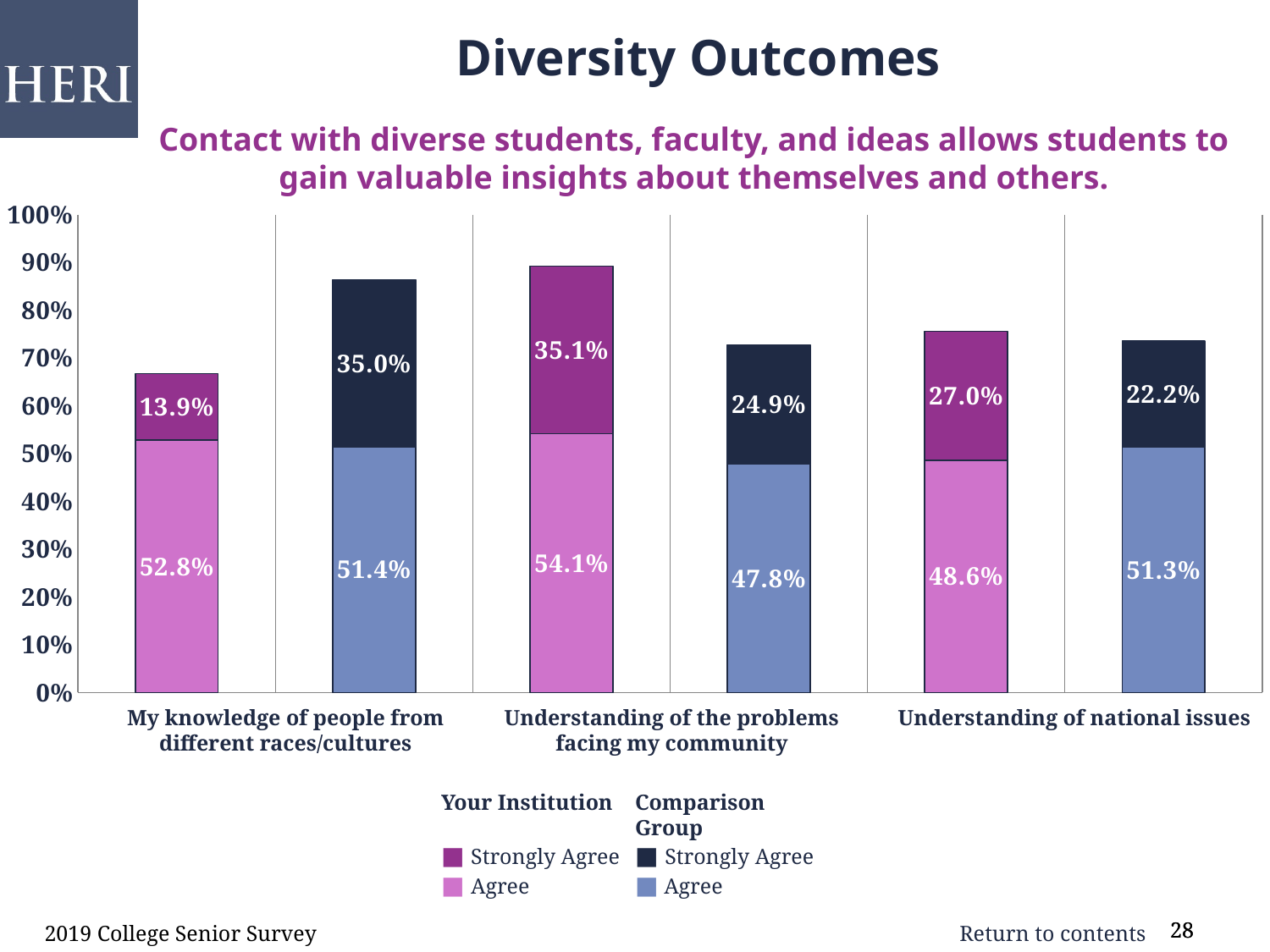
Among the Your Institution 'Strongly Agree' values, which category has the lowest? My knowledge of people from different races/cultures What is the 'Strongly Agree' value for the Comparison Group on 'Understanding of the problems facing my community'? 24.9% What is the total of the Your Institution stacked bar for 'Understanding of the problems facing my community'? 89.2% How many categories are shown on the x axis of the chart? 3 What kind of chart is shown on the slide? Stacked bar chart Among the Comparison Group 'Strongly Agree' values, which category has the highest? My knowledge of people from different races/cultures What percentage of Your Institution students 'Agree' for 'My knowledge of people from different races/cultures'? 52.8% What is the total of the Comparison Group stacked bar for 'My knowledge of people from different races/cultures'? 86.4% What is the difference between the Comparison Group 'Strongly Agree' value and the Your Institution 'Strongly Agree' value for 'My knowledge of people from different races/cultures'? 21.1% Which is larger for 'Understanding of national issues': the Your Institution 'Agree' value or the Comparison Group 'Agree' value? Comparison Group (51.3%) How many series does the legend list? 4 What is the 'Strongly Agree' value for Your Institution on 'Understanding of national issues'? 27.0%